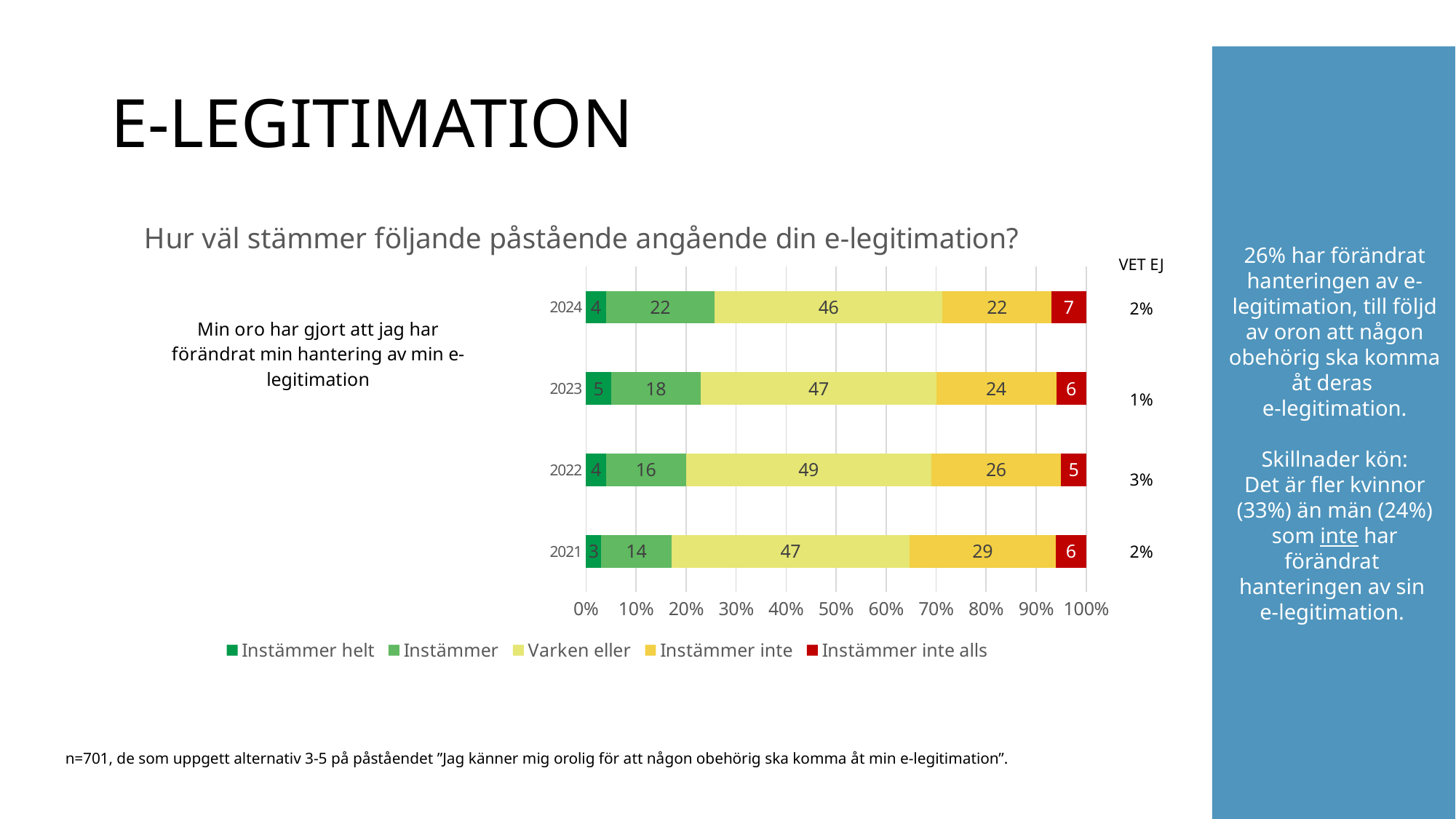
What is the value for "Instämmer inte" in 2021? 29 What is the value for "Instämmer inte alls" in 2024? 7 Which year has the larger value for "Instämmer inte": 2022 or 2023? 2022 Which year has the lowest value for "Instämmer helt"? 2021 What is the "VET EJ" percentage shown for 2022? 3% What is the value for "Varken eller" in 2024? 46 How many series does the legend list? 5 Which year has the highest value for "Varken eller"? 2022 What kind of chart is shown on the slide? Stacked bar chart How many years are shown in the chart? 4 What is the difference between the "Instämmer" values for 2024 and 2021? 8 Does the value for "Instämmer" rise or fall from 2021 to 2024? Rises